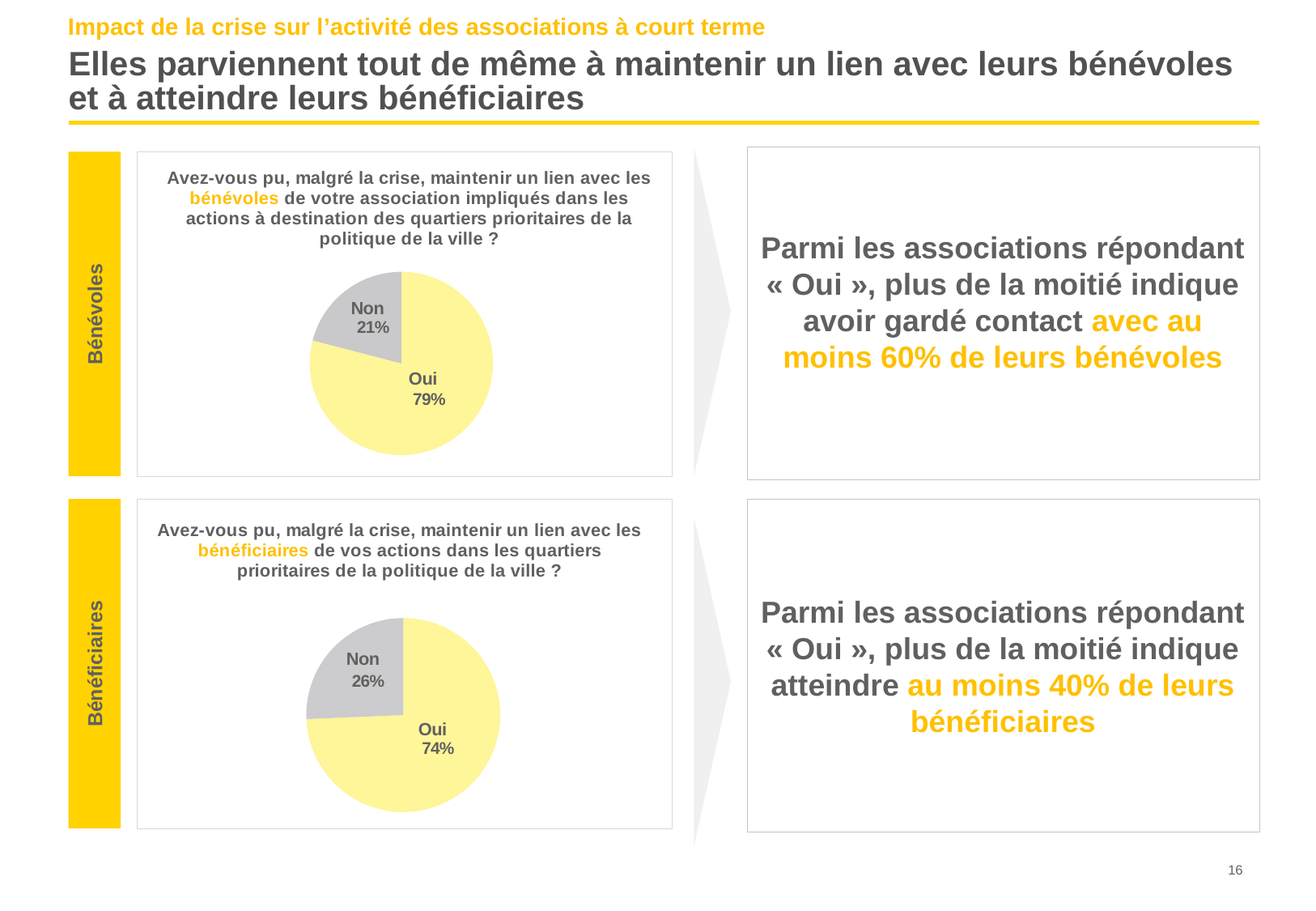
In the bottom pie chart (Bénéficiaires), what share of associations answered "Oui"? 74% In the bottom pie chart (Bénéficiaires), what is the difference in percentage points between "Oui" and "Non"? 48 percentage points In the bottom pie chart (Bénéficiaires), what share of associations answered "Non"? 26% In the bottom pie chart (Bénéficiaires), which answer has the smallest slice? Non How many slices does the top pie chart (Bénévoles) have? 2 In the top pie chart (Bénévoles), what share of associations answered "Non"? 21% Which chart has the larger "Oui" share, the top chart (Bénévoles) or the bottom chart (Bénéficiaires)? The top chart (Bénévoles) What type of chart is used in the bottom panel (Bénéficiaires)? Pie chart In the top pie chart (Bénévoles), what is the difference in percentage points between "Oui" and "Non"? 58 percentage points In the top pie chart (Bénévoles), what share of associations answered "Oui"? 79% In the top pie chart (Bénévoles), which answer has the largest slice? Oui In the bottom pie chart (Bénéficiaires), what colour is the "Non" slice? Grey